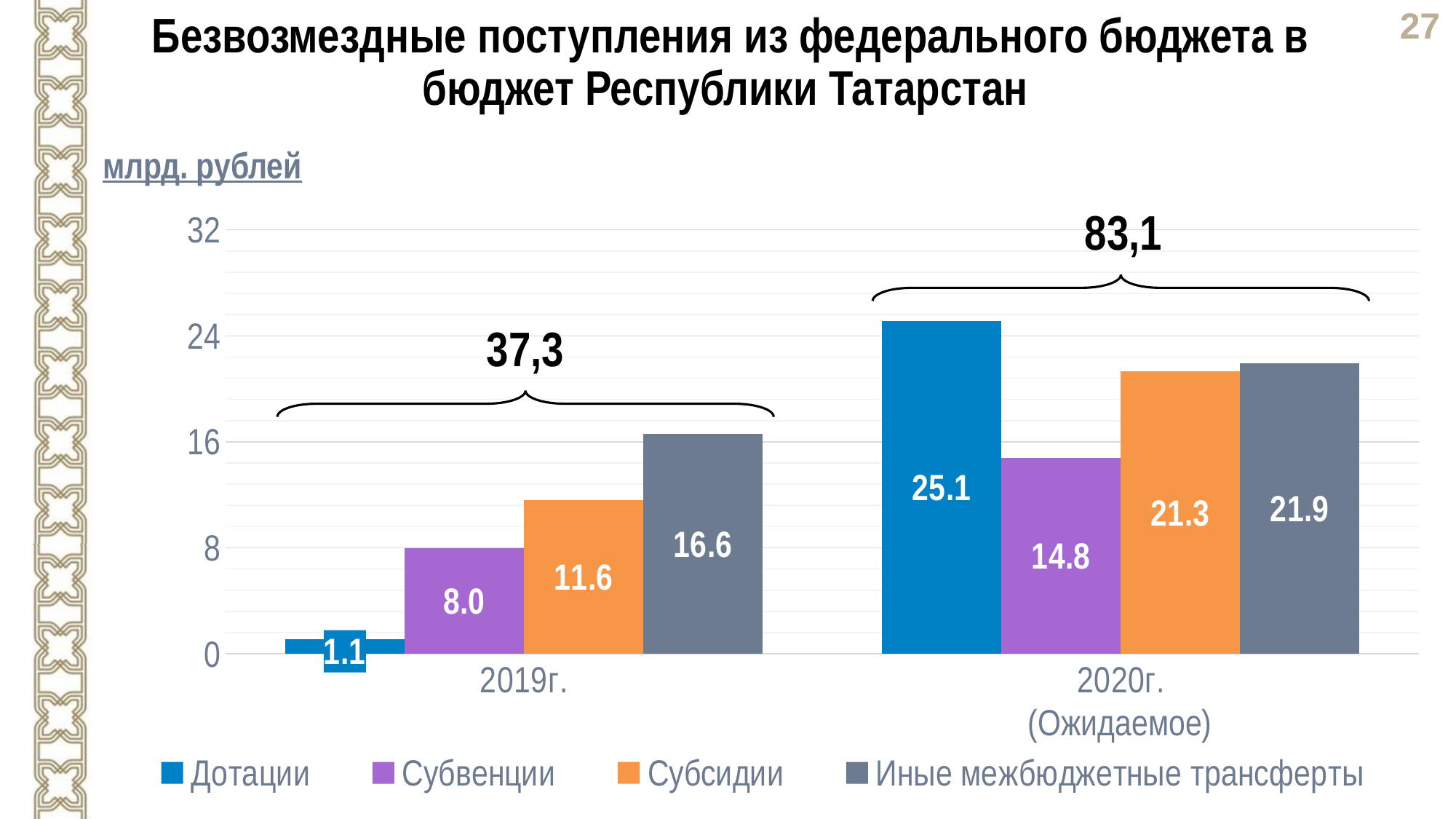
What is the value for Иные межбюджетные трансферты in 2019г.? 16.6 What is the difference between the Субвенции values for 2020г. (Ожидаемое) and 2019г.? 6.8 What kind of chart is shown on the slide? bar chart Is the value for Дотации in 2020г. (Ожидаемое) greater or less than 24? greater How many series does the legend list? 4 Which series has the highest value in 2020г. (Ожидаемое)? Дотации What is the value for Дотации in 2019г.? 1.1 What total is shown above the 2019г. group of bars? 37,3 Which series has the lowest value in 2019г.? Дотации What unit is stated above the chart? млрд. рублей What is the value for Субсидии in 2020г. (Ожидаемое)? 21.3 Which is larger in 2020г. (Ожидаемое): Субсидии or Иные межбюджетные трансферты? Иные межбюджетные трансферты